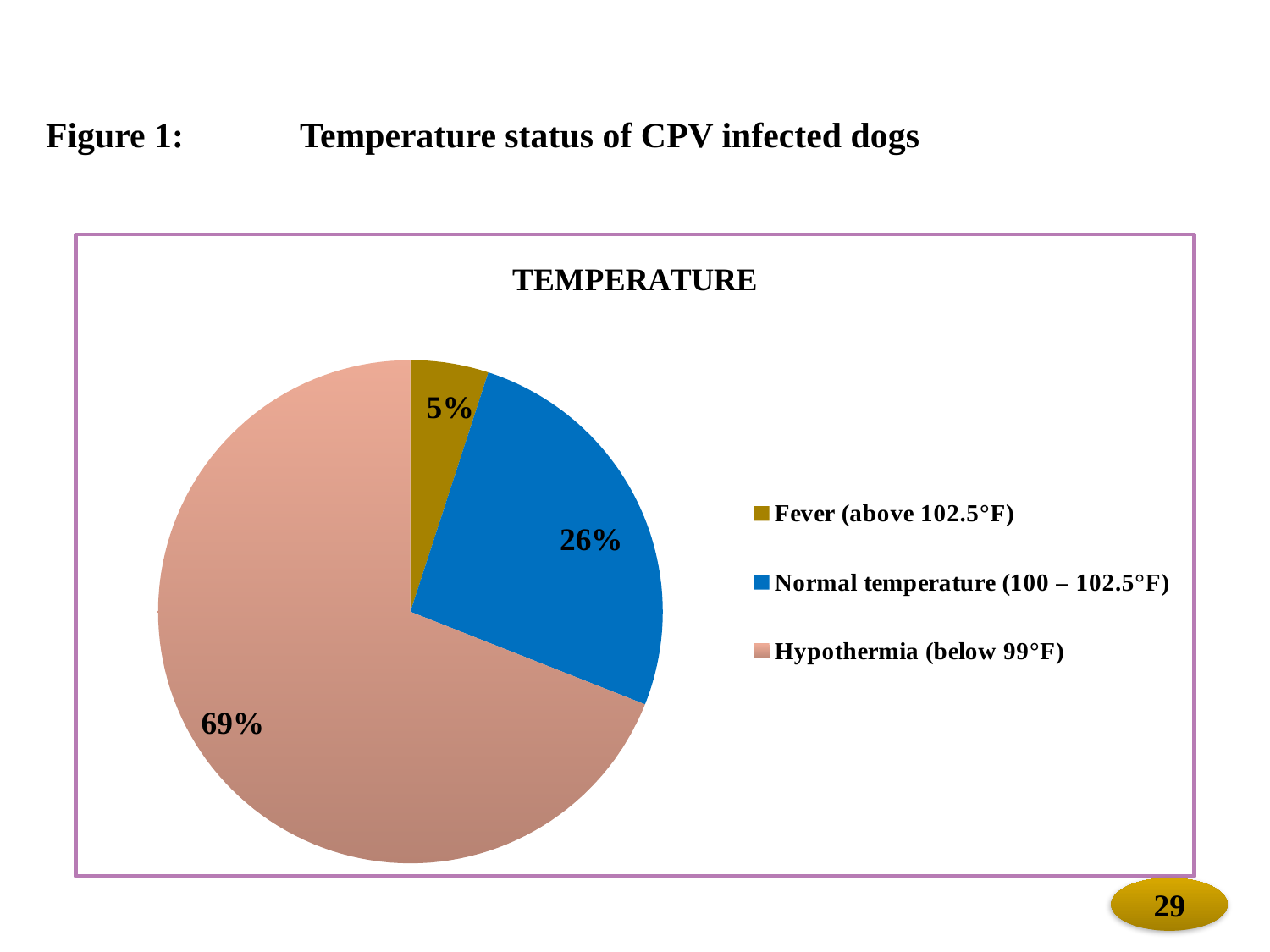
What percentage of CPV infected dogs had hypothermia (below 99°F)? 69% Which is larger, the share for normal temperature or the share for fever? Normal temperature (100 – 102.5°F) Which temperature category has the smallest share of the pie? Fever (above 102.5°F) What is the difference in percentage points between the normal temperature and fever slices? 21 Which temperature category has the largest share of the pie? Hypothermia (below 99°F) What percentage of CPV infected dogs had fever (above 102.5°F)? 5% What percentage of CPV infected dogs had normal temperature (100 – 102.5°F)? 26% What is the difference in percentage points between the hypothermia and normal temperature slices? 43 What colour is the slice representing hypothermia (below 99°F)? pink What is the title of the chart? TEMPERATURE What type of chart is shown on the slide? pie chart How many categories does the pie chart show? 3